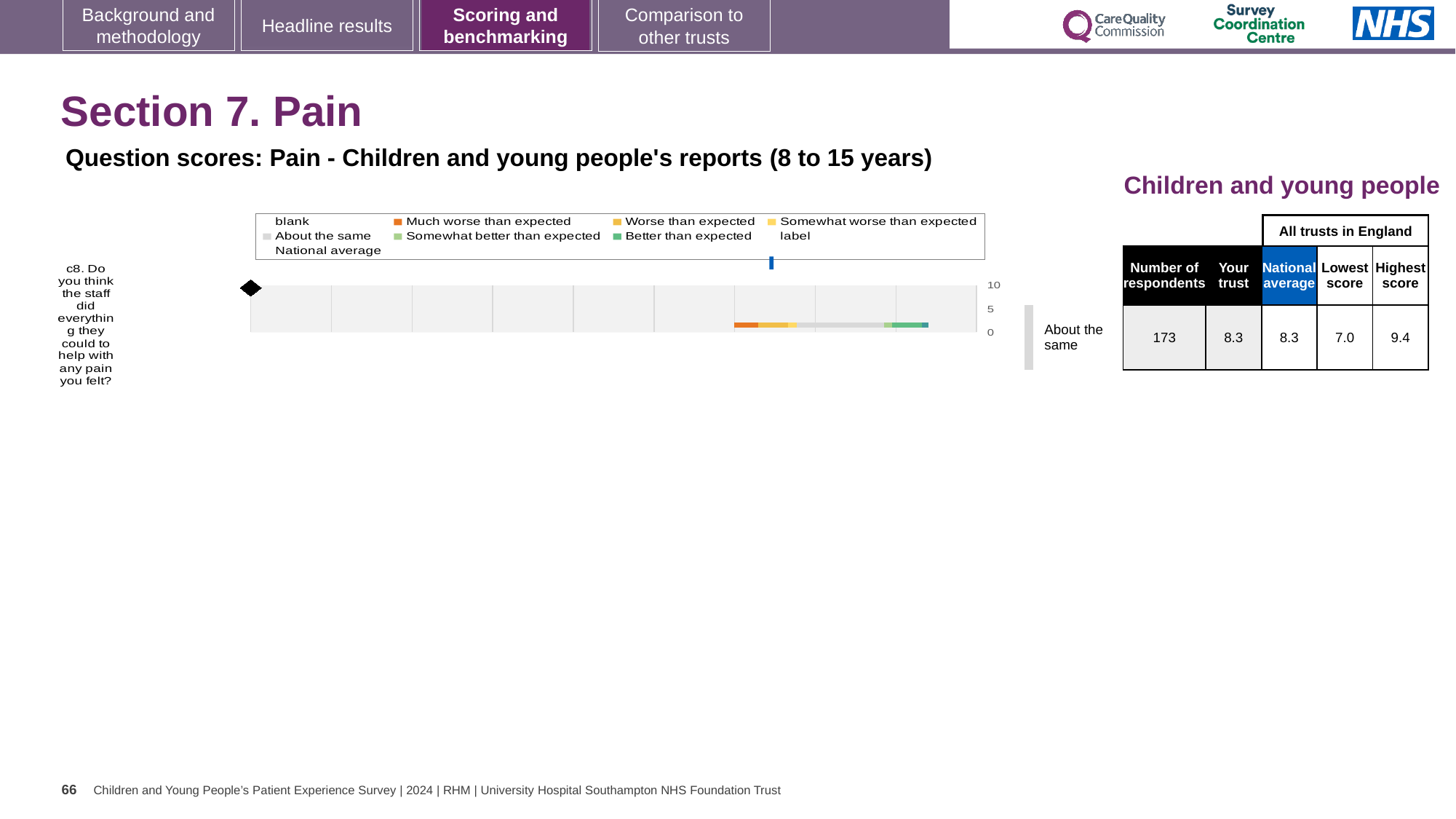
According to the table beside the chart, what is the Lowest score among all trusts in England for question c8? 7.0 What is the difference between the Highest score and the Lowest score shown in the table beside the chart? 2.4 What kind of chart is shown on the slide? bar chart Which is larger in the table beside the chart: the Highest score or the Your trust score? Highest score According to the table beside the chart, how many respondents answered question c8? 173 How many questions (categories) are plotted in the chart? 1 Which question is plotted in the chart? c8. Do you think the staff did everything they could to help with any pain you felt? According to the table beside the chart, what is the National average score for question c8? 8.3 According to the table beside the chart, what is the 'Your trust' score for question c8? 8.3 According to the table beside the chart, what is the Highest score among all trusts in England for question c8? 9.4 What is the highest value shown on the chart's numeric axis? 10